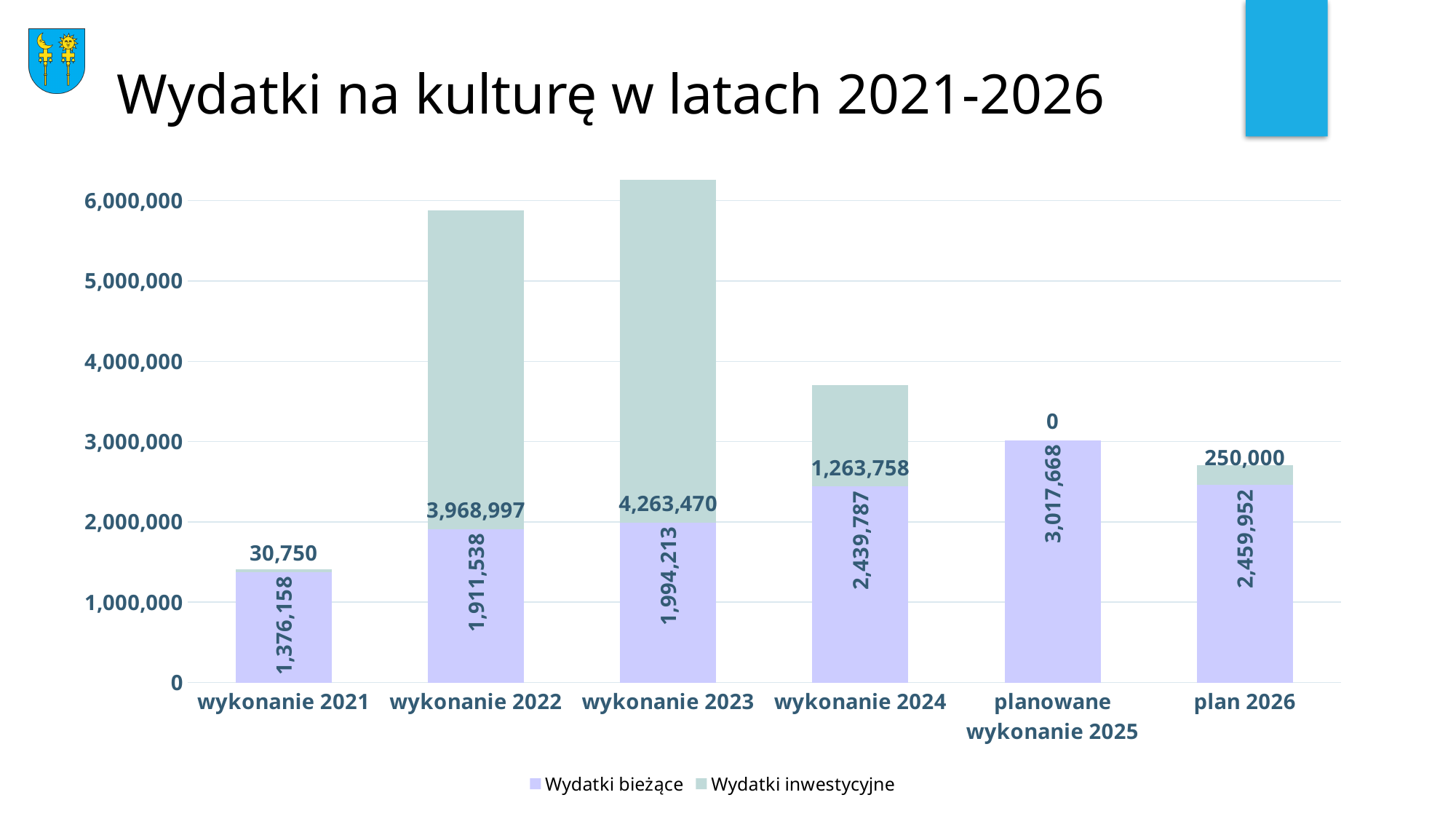
Is Wydatki inwestycyjne larger for wykonanie 2022 or for wykonanie 2024? wykonanie 2022 What is the total of the stacked bar for wykonanie 2021? 1,406,908 What is the value of Wydatki inwestycyjne for wykonanie 2022? 3,968,997 What is the value of Wydatki bieżące for wykonanie 2023? 1,994,213 What type of chart is shown on the slide? stacked bar chart What is the value of Wydatki inwestycyjne for planowane wykonanie 2025? 0 How many series does the legend list? 2 Which category has the lowest value of Wydatki bieżące? wykonanie 2021 How many categories are shown on the x axis? 6 Which category has the highest value of Wydatki inwestycyjne? wykonanie 2023 What is the difference between Wydatki bieżące for plan 2026 and for wykonanie 2024? 20,165 Which category has the highest value of Wydatki bieżące? planowane wykonanie 2025